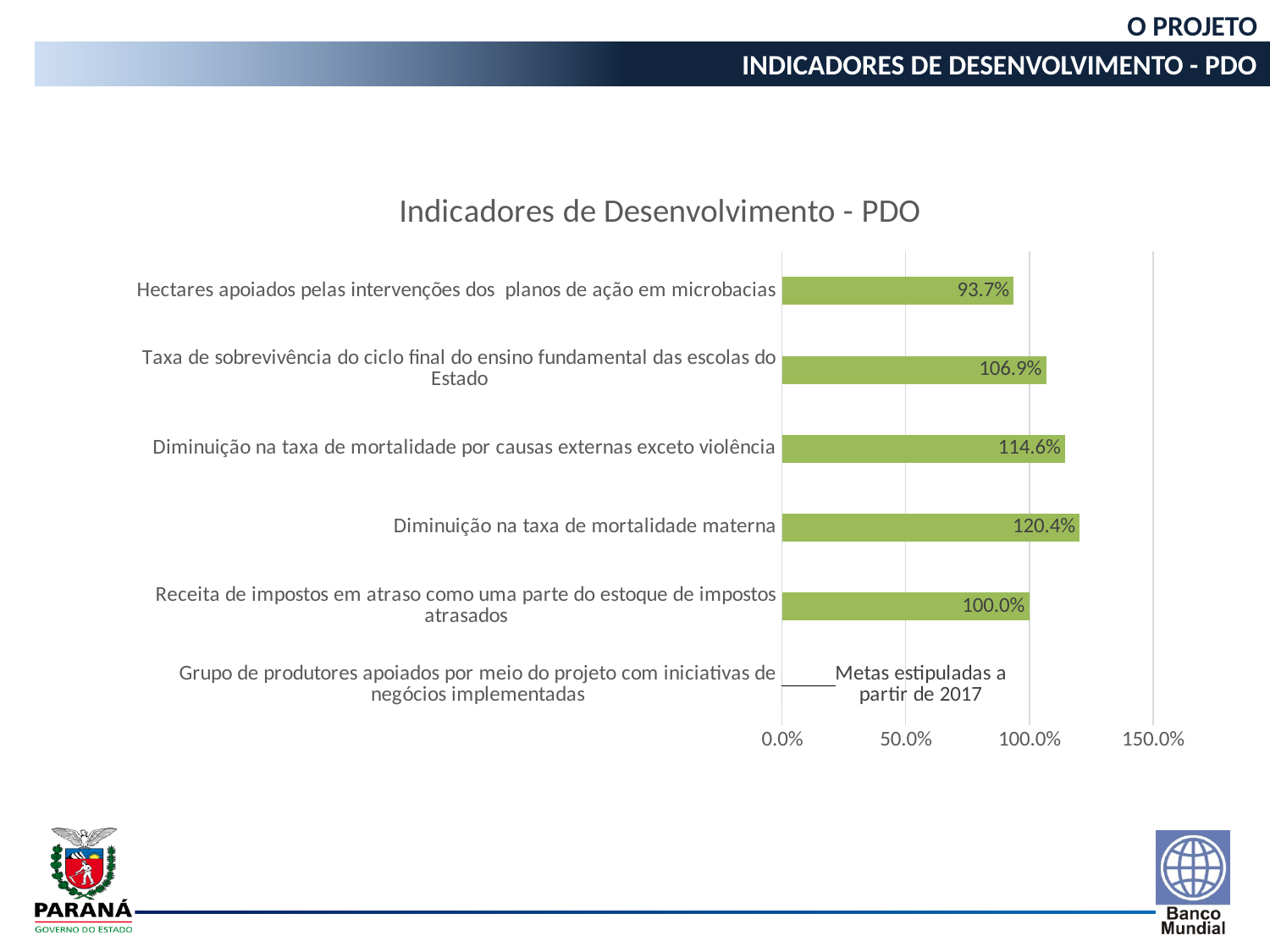
What is the title of the chart? Indicadores de Desenvolvimento - PDO What is the value for "Taxa de sobrevivência do ciclo final do ensino fundamental das escolas do Estado"? 106.9% Which is larger: the value for "Taxa de sobrevivência do ciclo final do ensino fundamental das escolas do Estado" or the value for "Diminuição na taxa de mortalidade por causas externas exceto violência"? Diminuição na taxa de mortalidade por causas externas exceto violência What is the value for "Hectares apoiados pelas intervenções dos planos de ação em microbacias"? 93.7% What is the value for "Receita de impostos em atraso como uma parte do estoque de impostos atrasados"? 100.0% What type of chart is shown on the slide? bar chart What is the difference between the values for "Diminuição na taxa de mortalidade materna" and "Hectares apoiados pelas intervenções dos planos de ação em microbacias"? 26.7% What is the value for "Diminuição na taxa de mortalidade por causas externas exceto violência"? 114.6% What is the value for "Diminuição na taxa de mortalidade materna"? 120.4% Which indicator with a plotted bar has the lowest value? Hectares apoiados pelas intervenções dos planos de ação em microbacias What text is shown in place of a bar for "Grupo de produtores apoiados por meio do projeto com iniciativas de negócios implementadas"? Metas estipuladas a partir de 2017 Which indicator has the highest value? Diminuição na taxa de mortalidade materna